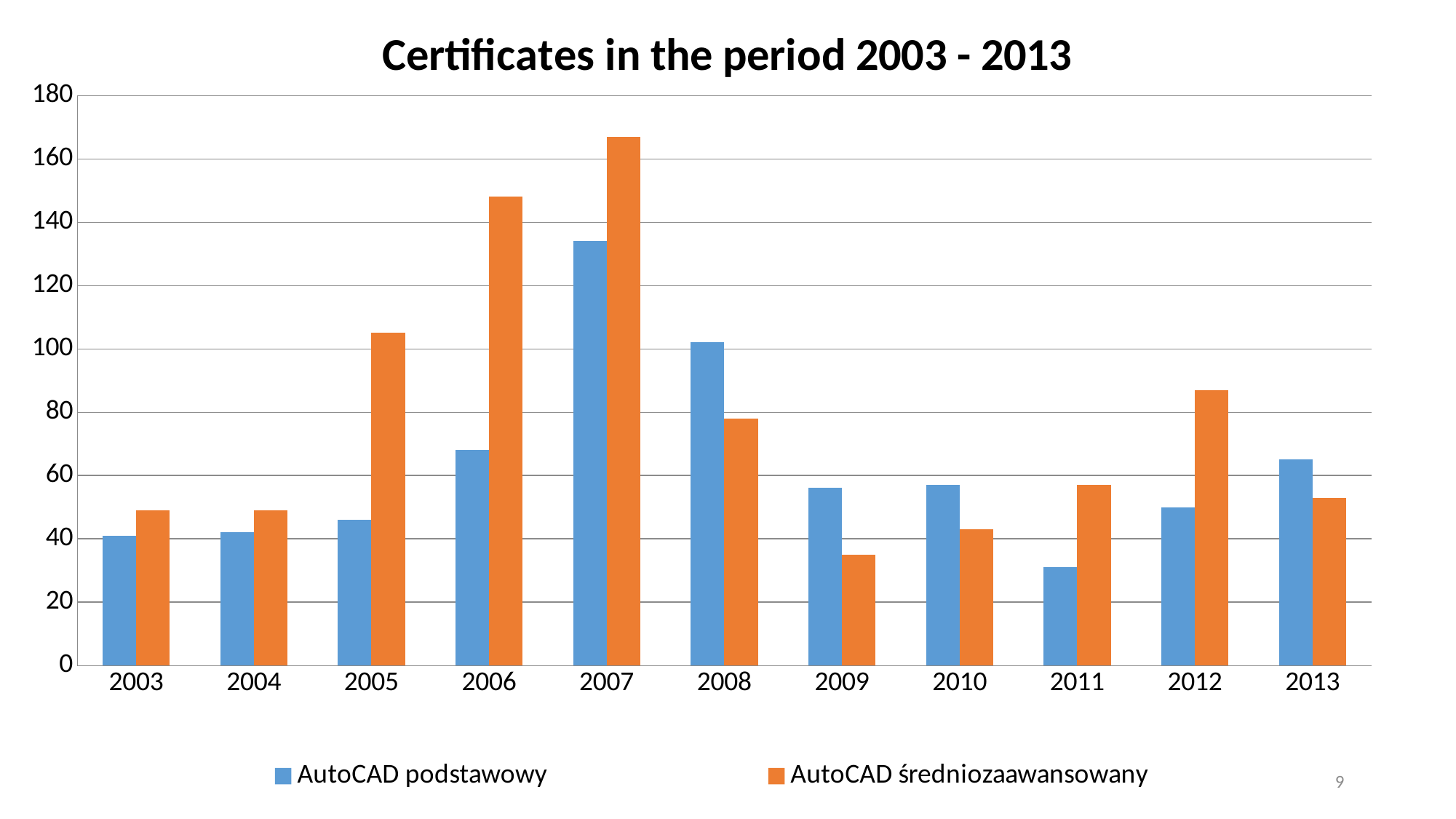
Is the value for AutoCAD podstawowy in 2007 greater or less than 140? less Do the values for AutoCAD średniozaawansowany rise or fall from 2003 to 2007? rise In which year is the value for AutoCAD średniozaawansowany lowest? 2009 How many series does the legend list? 2 What type of chart is shown on the slide? bar chart In which year is the value for AutoCAD podstawowy lowest? 2011 In 2008, which series has the larger value, AutoCAD podstawowy or AutoCAD średniozaawansowany? AutoCAD podstawowy How many years are shown on the x axis? 11 Is the value for AutoCAD średniozaawansowany in 2007 greater or less than 160? greater What is the title of the chart? Certificates in the period 2003 - 2013 In which year is the value for AutoCAD podstawowy highest? 2007 In which year is the value for AutoCAD średniozaawansowany highest? 2007